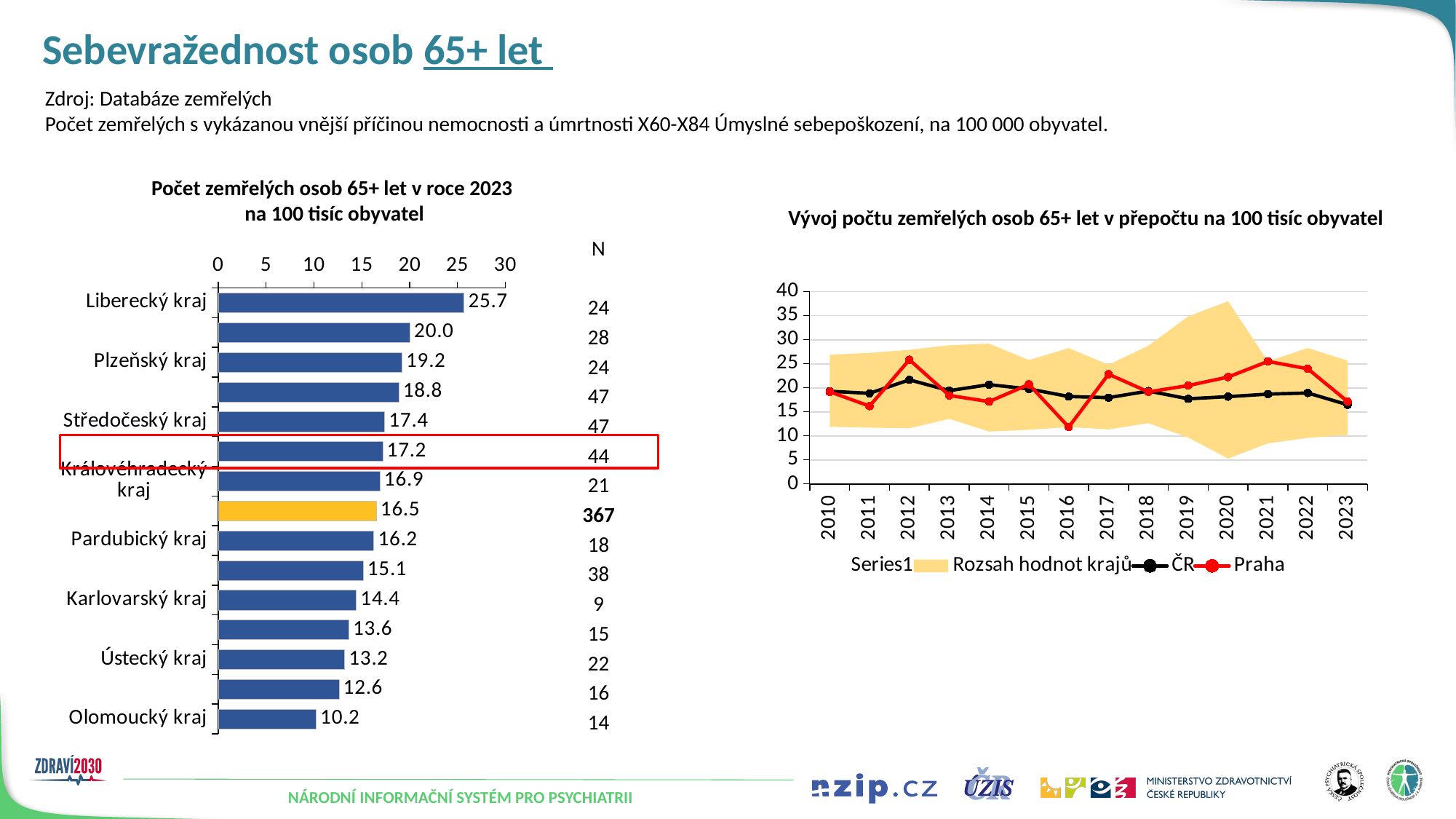
On the right chart, which is larger in 2016, the value for ČR or for Praha? ČR On the left chart, how many bars are plotted? 15 On the right chart 'Vývoj počtu zemřelých osob 65+ let v přepočtu na 100 tisíc obyvatel', is the value for Praha in 2016 greater or less than 15? less On the left chart, which region has the highest value? Liberecký kraj On the left chart, what is the value for Pardubický kraj? 16.2 On the left chart, which region has the lowest value? Olomoucký kraj On the left chart, which is larger, the value for Středočeský kraj or Karlovarský kraj? Středočeský kraj On the right chart, how many years are shown on the x axis? 14 On the left chart, what is the difference between the values for Plzeňský kraj and Ústecký kraj? 6.0 What kind of chart is the chart on the left? Bar chart On the left chart, what is the value for Olomoucký kraj? 10.2 On the left chart, what is the value for Liberecký kraj? 25.7